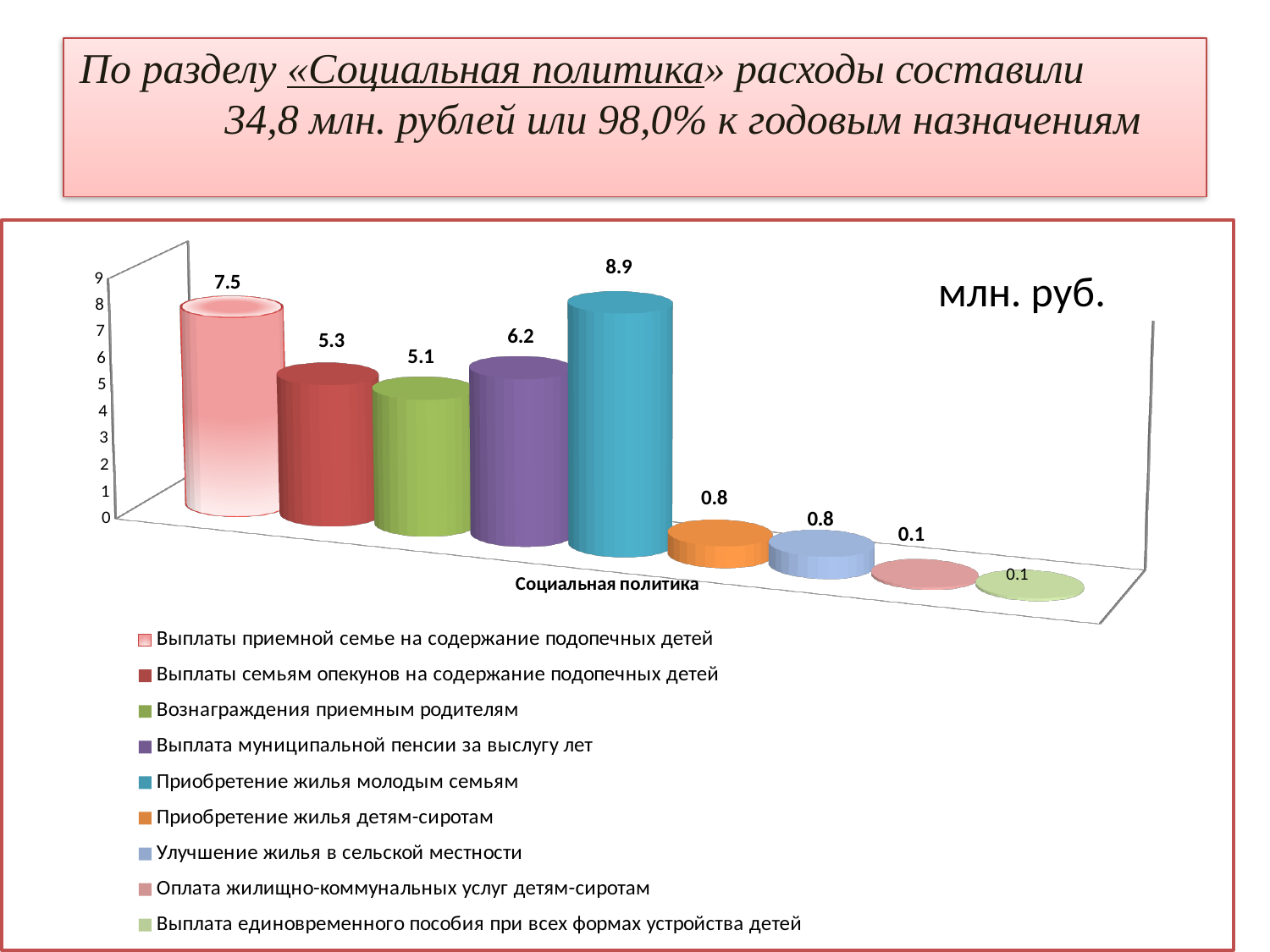
What is the value for «Вознаграждения приемным родителям»? 5.1 Which series has the highest value? Приобретение жилья молодым семьям What is the value for «Выплаты приемной семье на содержание подопечных детей»? 7.5 What kind of chart is shown on the slide? Bar chart What is the value for «Приобретение жилья детям-сиротам»? 0.8 What is the difference between «Приобретение жилья молодым семьям» and «Выплаты приемной семье на содержание подопечных детей»? 1.4 What is the difference between «Выплаты семьям опекунов на содержание подопечных детей» and «Вознаграждения приемным родителям»? 0.2 What is the value for «Приобретение жилья молодым семьям»? 8.9 What unit is indicated on the chart? млн. руб. What is the value for «Выплата муниципальной пенсии за выслугу лет»? 6.2 How many series does the legend list? 9 Which is larger: «Выплата муниципальной пенсии за выслугу лет» or «Выплаты семьям опекунов на содержание подопечных детей»? Выплата муниципальной пенсии за выслугу лет